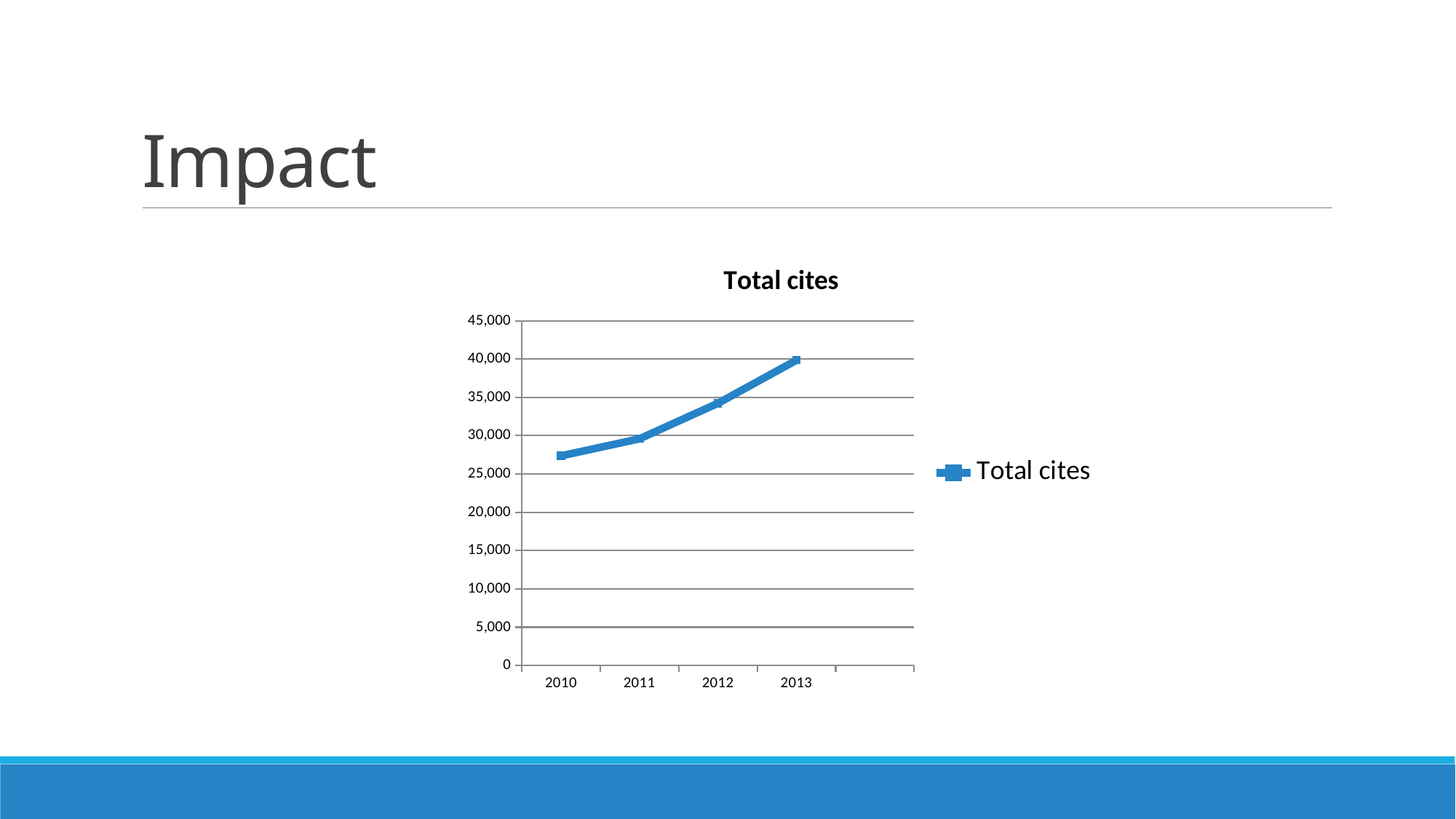
Is the value for 2012 greater or less than 30,000? greater How many series does the legend list? 1 Do the values rise or fall from 2010 to 2013? rise How many years are plotted on the x axis? 4 Which year has the lowest value for Total cites? 2010 Is the value for 2013 greater or less than 35,000? greater Which year has the highest value for Total cites? 2013 What kind of chart is shown on the slide? line chart Which is larger, the value for 2013 or the value for 2010? 2013 What is the title of the chart? Total cites Is the value for 2010 greater or less than 25,000? greater